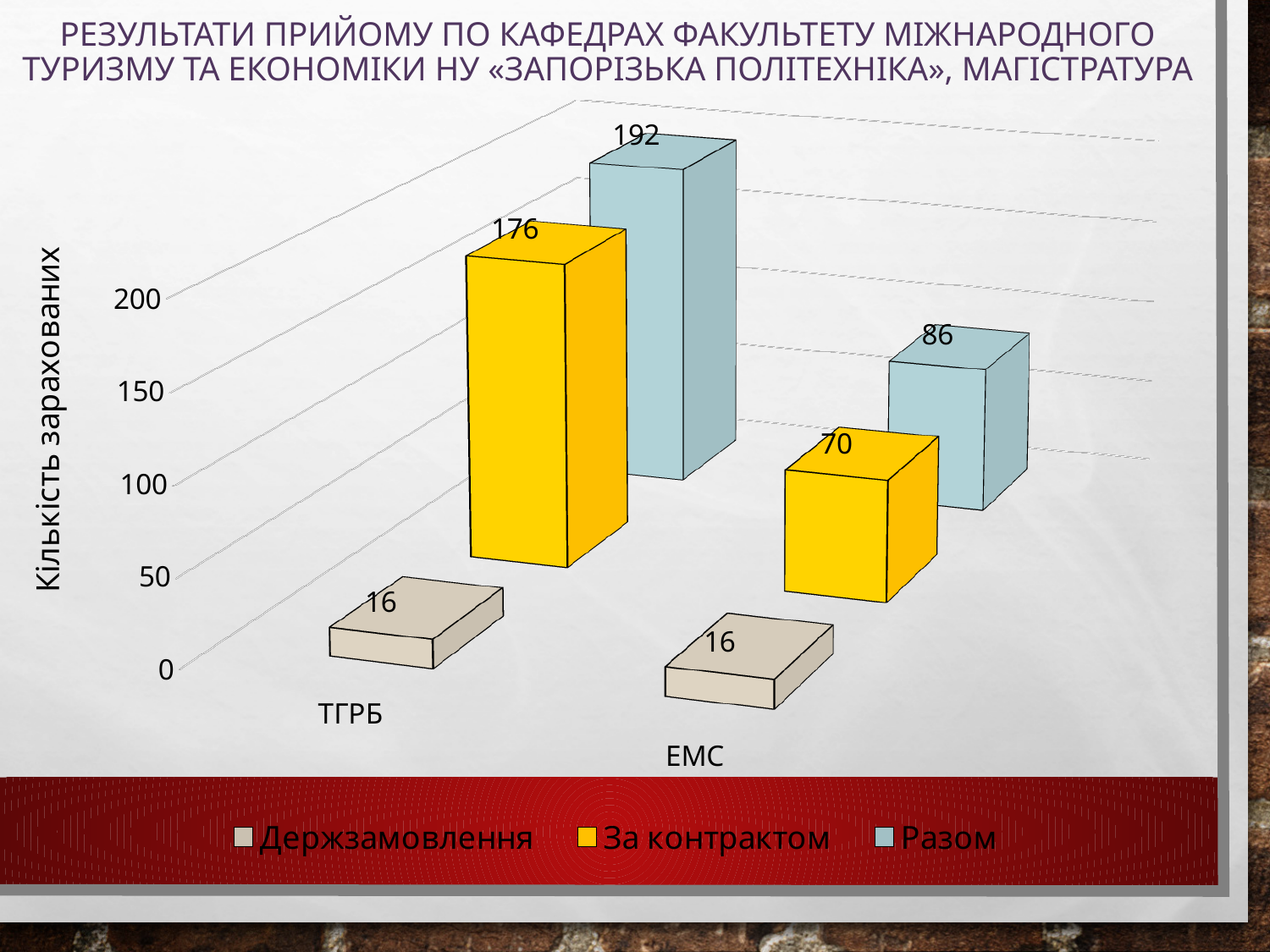
What is the difference between Разом and За контрактом for ЕМС? 16 What is the difference between the За контрактом values for ТГРБ and ЕМС? 106 Which series has the lowest value for ТГРБ? Держзамовлення Which category has the higher Разом value? ТГРБ How many series does the legend list? 3 What is the value of Держзамовлення for ЕМС? 16 How many categories are shown on the x axis? 2 What kind of chart is shown on the slide? Bar chart What is the value of Разом for ЕМС? 86 What is the value of За контрактом for ТГРБ? 176 Which is larger: Разом for ЕМС or За контрактом for ТГРБ? За контрактом for ТГРБ What is the label of the vertical axis? Кількість зарахованих